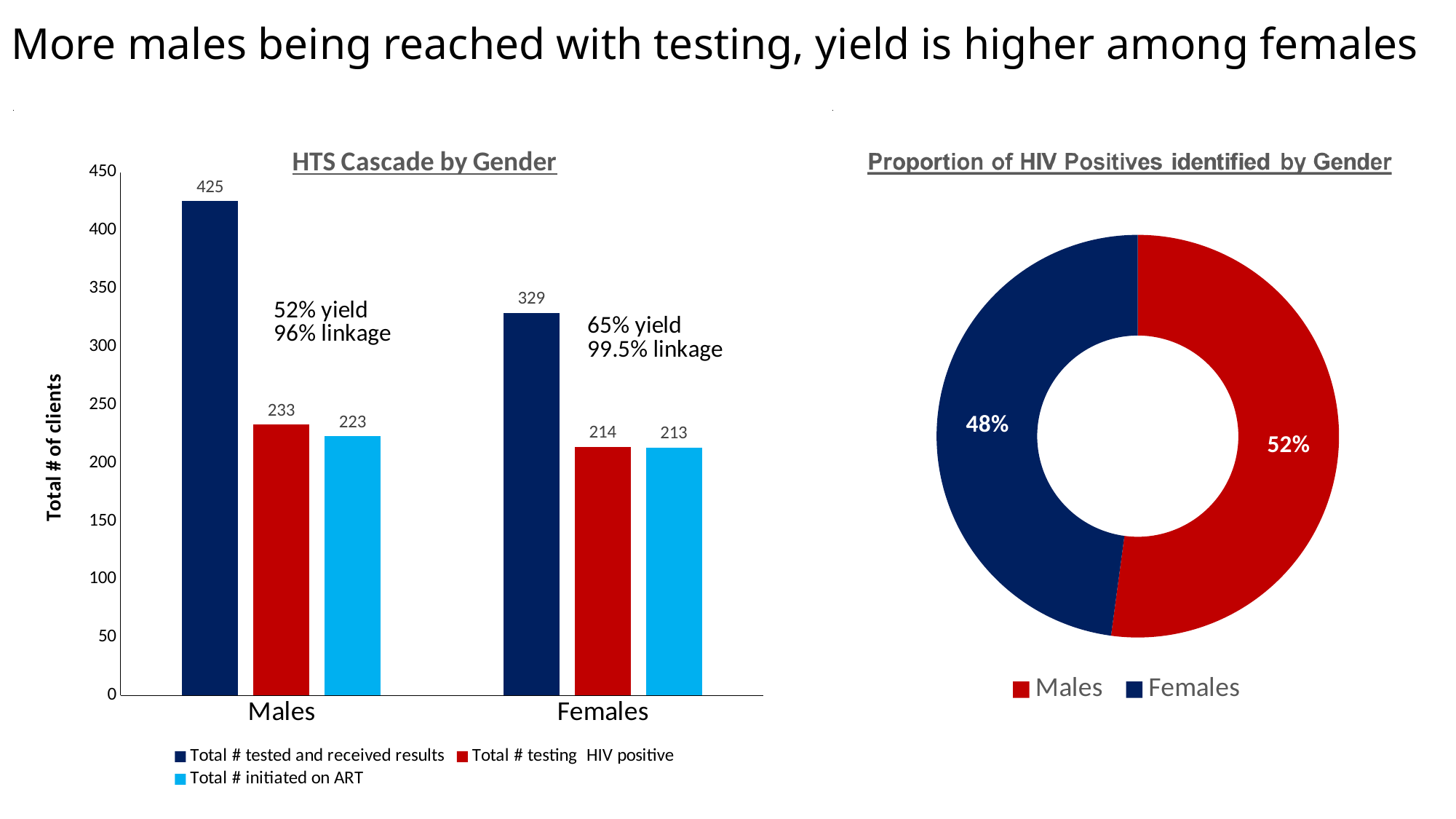
What kind of chart is 'Proportion of HIV Positives identified by Gender'? Doughnut chart In the 'HTS Cascade by Gender' chart, what is the difference between 'Total # testing HIV positive' and 'Total # initiated on ART' for Males? 10 What is the y-axis title of the 'HTS Cascade by Gender' chart? Total # of clients In the 'Proportion of HIV Positives identified by Gender' chart, what share is shown for Males? 52% In the 'HTS Cascade by Gender' chart, what is the difference between 'Total # tested and received results' for Males and for Females? 96 In the 'HTS Cascade by Gender' chart, what is the value of 'Total # tested and received results' for Males? 425 In the 'HTS Cascade by Gender' chart, what is the value of 'Total # initiated on ART' for Males? 223 In the 'Proportion of HIV Positives identified by Gender' chart, what share is shown for Females? 48% In the 'HTS Cascade by Gender' chart, what is the value of 'Total # testing HIV positive' for Females? 214 What kind of chart is 'HTS Cascade by Gender'? Bar chart How many series does the legend of the 'HTS Cascade by Gender' chart list? 3 In the 'HTS Cascade by Gender' chart, which gender has the higher value for 'Total # tested and received results'? Males